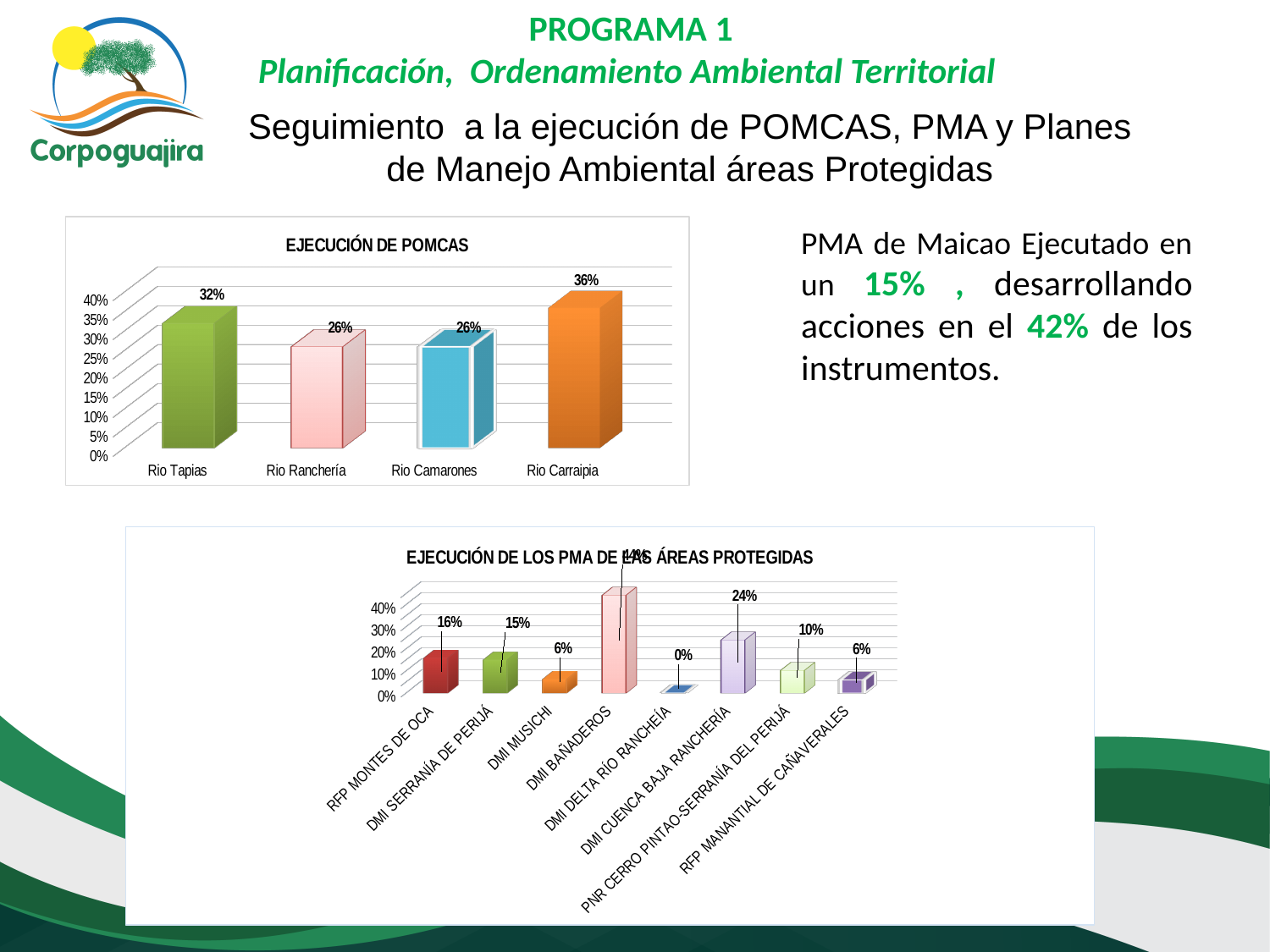
In the 'EJECUCIÓN DE LOS PMA DE LAS ÁREAS PROTEGIDAS' chart, which is larger, RFP MONTES DE OCA or DMI SERRANÍA DE PERIJÁ? RFP MONTES DE OCA In the 'EJECUCIÓN DE LOS PMA DE LAS ÁREAS PROTEGIDAS' chart, which category has the lowest value? DMI DELTA RÍO RANCHEÍA In the 'EJECUCIÓN DE POMCAS' chart, what is the value for Rio Ranchería? 26% In the 'EJECUCIÓN DE LOS PMA DE LAS ÁREAS PROTEGIDAS' chart, how many categories are shown? 8 In the 'EJECUCIÓN DE POMCAS' chart, which category has the highest value? Rio Carraipia In the 'EJECUCIÓN DE POMCAS' chart, what is the difference between Rio Carraipia and Rio Tapias? 4% In the 'EJECUCIÓN DE POMCAS' chart, how many categories are shown? 4 What kind of chart is the 'EJECUCIÓN DE POMCAS' chart? Bar chart In the 'EJECUCIÓN DE POMCAS' chart, what is the value for Rio Tapias? 32% In the 'EJECUCIÓN DE LOS PMA DE LAS ÁREAS PROTEGIDAS' chart, is the value for DMI BAÑADEROS greater or less than 40%? greater In the 'EJECUCIÓN DE LOS PMA DE LAS ÁREAS PROTEGIDAS' chart, what is the value for DMI CUENCA BAJA RANCHERÍA? 24% In the 'EJECUCIÓN DE LOS PMA DE LAS ÁREAS PROTEGIDAS' chart, which category has the highest value? DMI BAÑADEROS